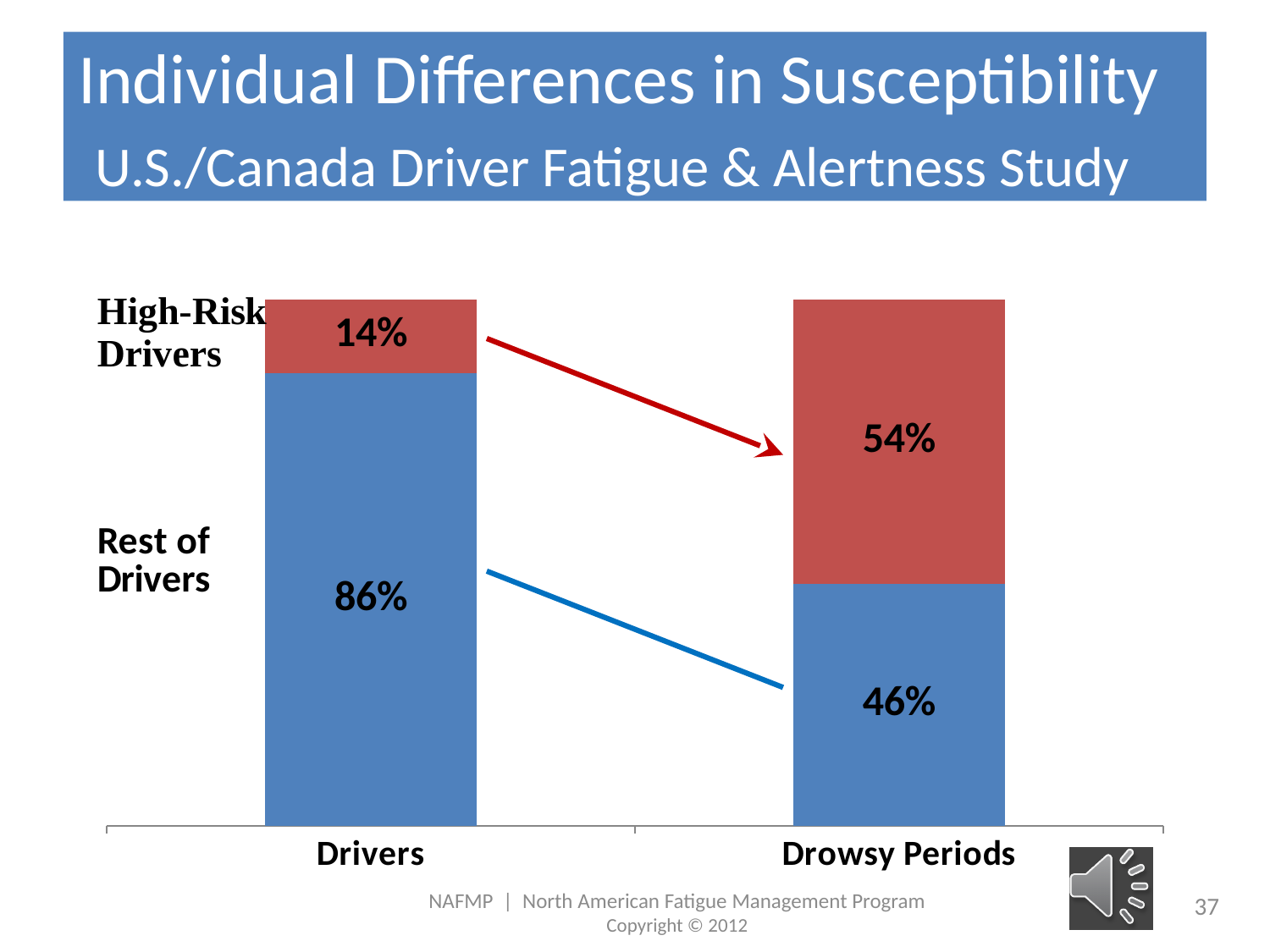
In the Drowsy Periods bar, which group has the larger share: High-Risk Drivers or Rest of Drivers? High-Risk Drivers Which colour represents High-Risk Drivers in the chart? Red What percentage of Drowsy Periods are attributed to High-Risk Drivers? 54% What is the difference between the High-Risk Drivers share of Drowsy Periods and their share of Drivers? 40% What is the difference between the Rest of Drivers share of Drivers and their share of Drowsy Periods? 40% What kind of chart is shown on the slide? Stacked bar chart Which is larger: the High-Risk Drivers share of Drivers or the High-Risk Drivers share of Drowsy Periods? Drowsy Periods What percentage of Drivers are in the Rest of Drivers group? 86% What percentage of Drowsy Periods are attributed to the Rest of Drivers? 46% What percentage of Drivers are High-Risk Drivers? 14% What is the total of the Drivers stacked bar? 100% How many categories are shown on the x axis? 2